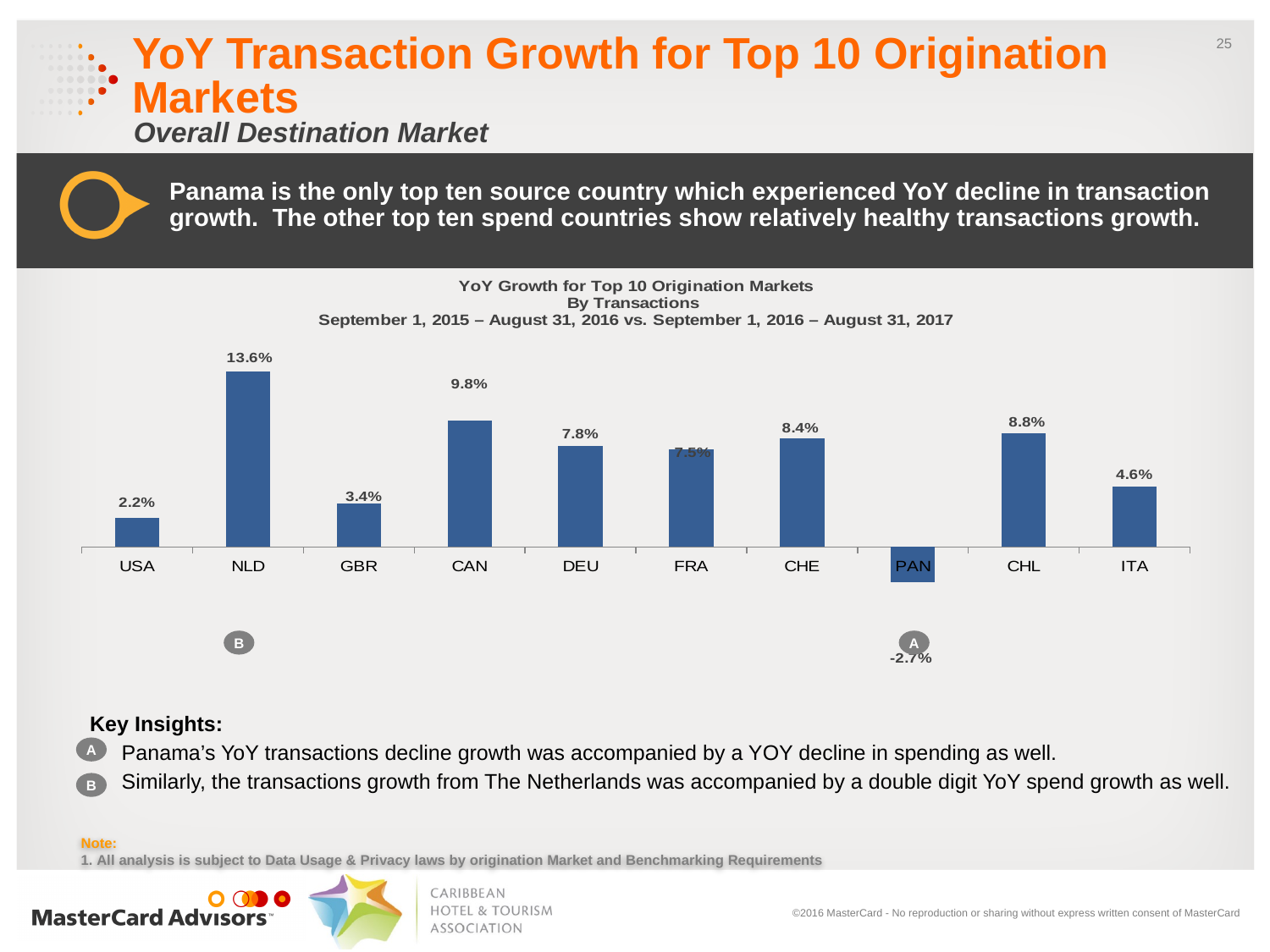
What is the YoY transaction growth value for NLD? 13.6% Which origination market has the lowest YoY transaction growth? PAN What is the difference between the YoY transaction growth of NLD and CAN? 3.8% Which has a higher YoY transaction growth, CHE or DEU? CHE Which origination market is the only one with a negative YoY transaction growth? PAN What type of chart is used to show YoY transaction growth? Bar chart What is the difference between the YoY transaction growth of CHL and USA? 6.6% What is the YoY transaction growth value for PAN? -2.7% What is the YoY transaction growth value for CAN? 9.8% How many origination markets are shown in the chart? 10 What is the YoY transaction growth value for ITA? 4.6% Which origination market has the highest YoY transaction growth? NLD